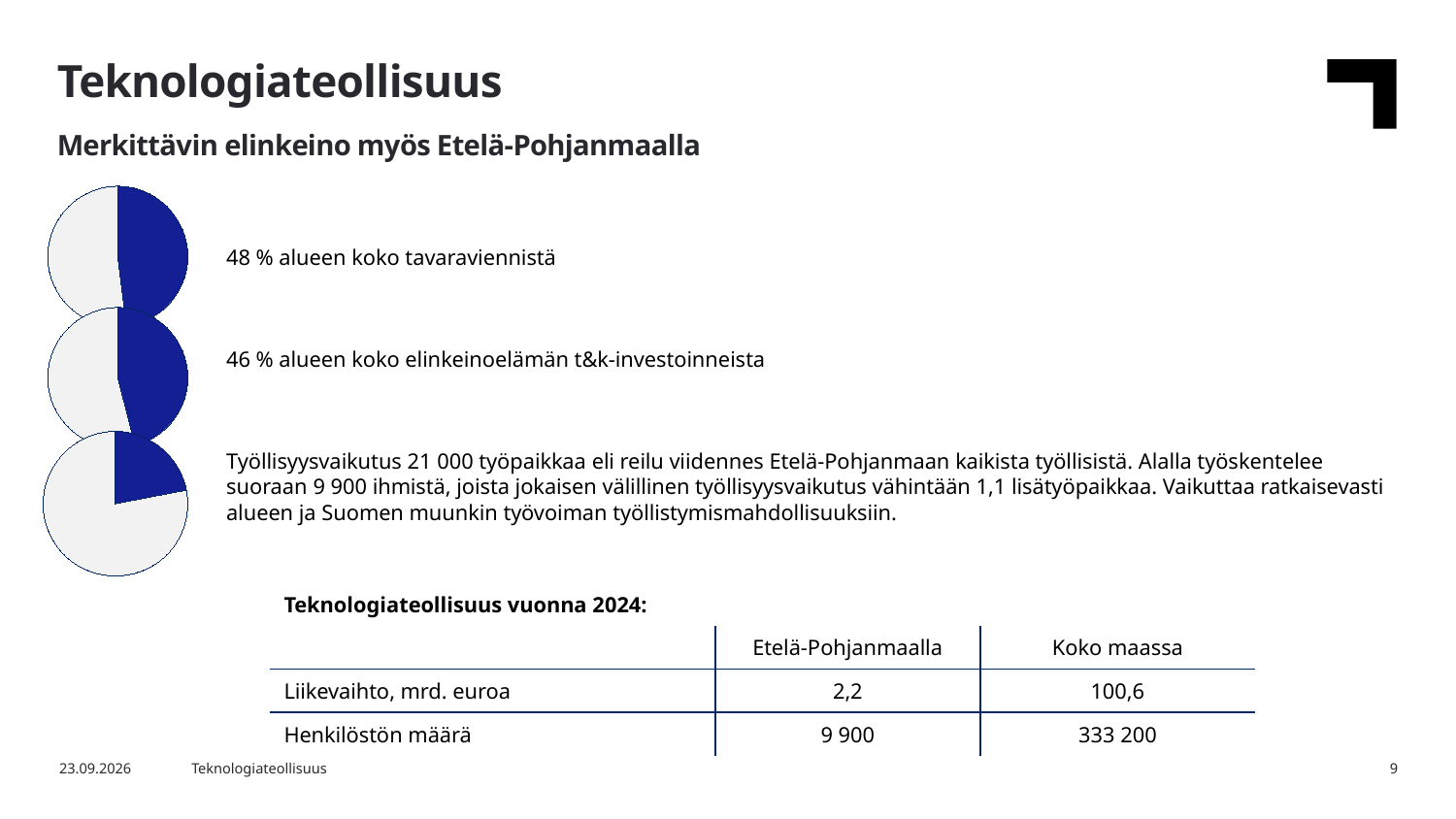
What is the difference between the shares shown by the top pie chart (48 %) and the middle pie chart (46 %)? 2 percentage points Which pie chart has the larger blue slice, the top one (48 %) or the middle one (46 %)? the top one Which of the three pie charts has the smallest blue slice? the bottom one How many slices does the top pie chart have? 2 In the bottom pie chart, is the blue slice larger or smaller than the grey slice? smaller In the middle pie chart, what share of the region's business R&D investments does the blue slice represent? 46 % What kind of chart is shown at the top left of the slide? pie chart What colour is the highlighted slice in each pie chart? blue In the top pie chart, is the blue slice larger or smaller than the grey slice? smaller What does the bottom pie chart illustrate, according to the text next to it? the employment effect, just over a fifth of all employed people in Etelä-Pohjanmaa In the top pie chart, what share of the region's total goods exports does the blue slice represent? 48 % How many pie charts are on the slide? 3